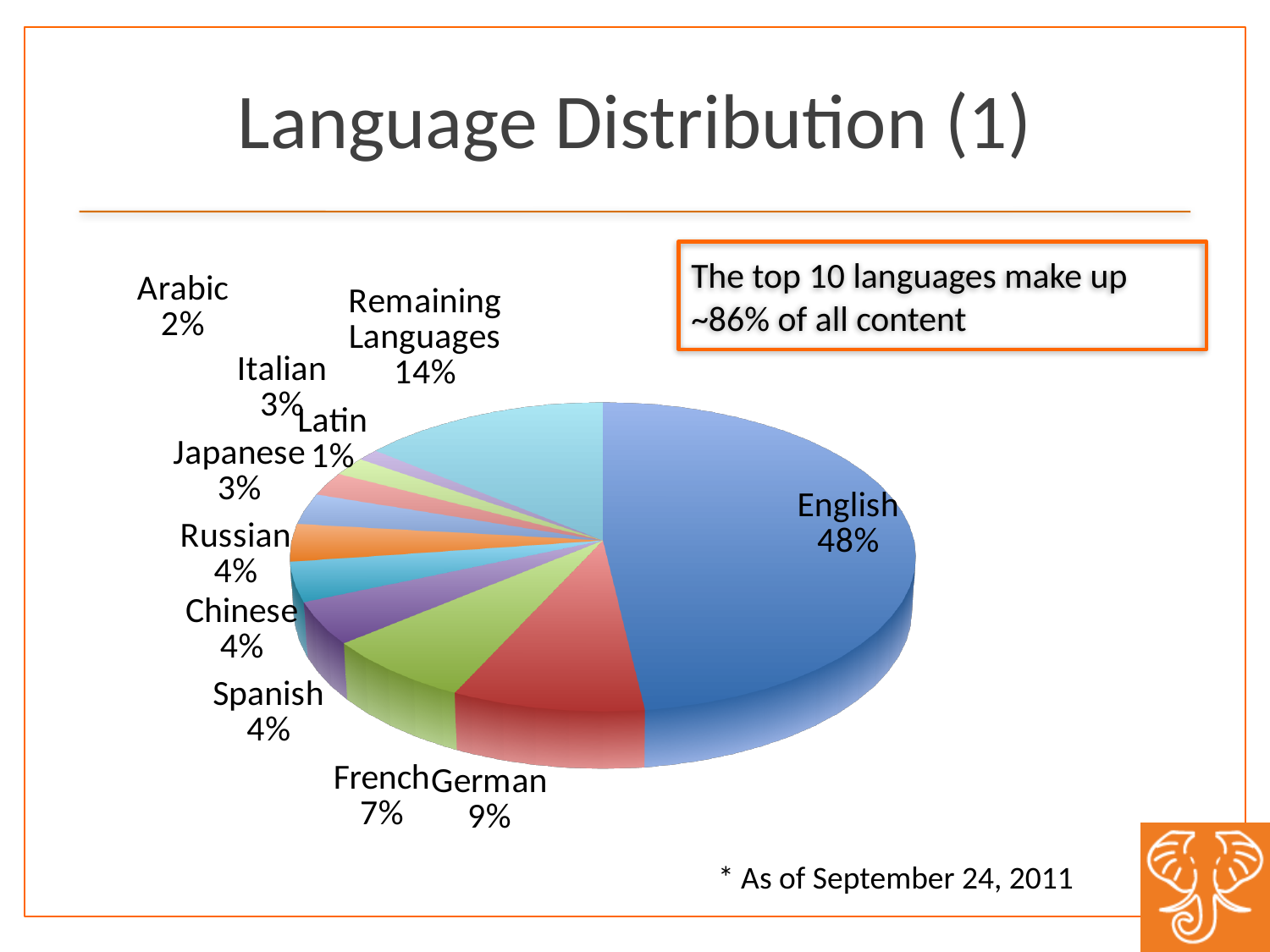
What is the difference in percentage points between German and French? 2 What percentage is shown for German? 9% What percentage is shown for Remaining Languages? 14% Which is larger, the share for Japanese or the share for Arabic? Japanese Which language has the largest slice of the pie? English What is the combined share of English and German? 57% What percentage is shown for Latin? 1% Which labelled slice has the smallest share? Latin How many slices does the pie chart have? 11 What is the title of the slide containing the chart? Language Distribution (1) What share of the pie does English have? 48% What type of chart is shown on the slide? Pie chart